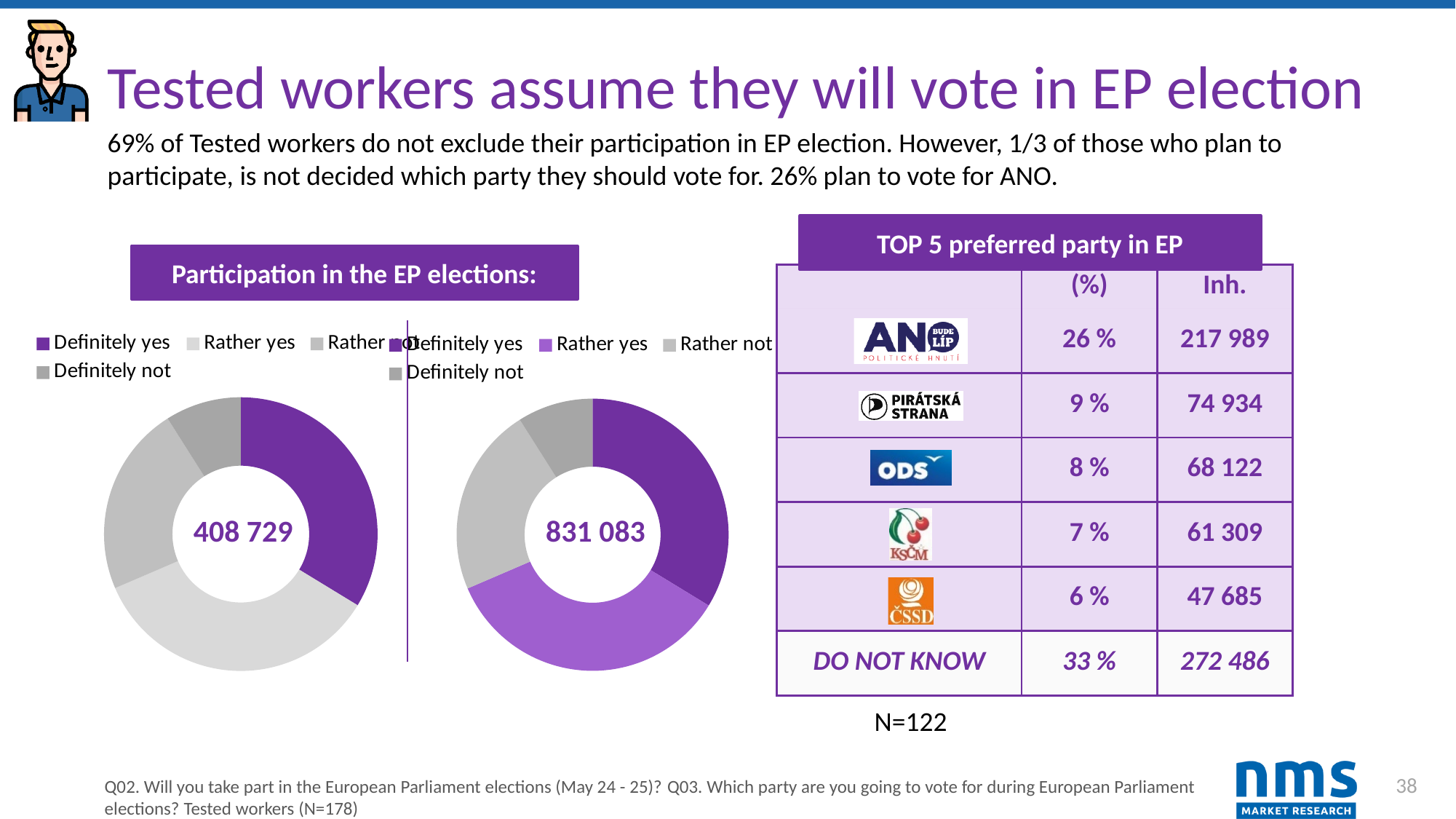
In the left donut chart, which slice is larger: 'Definitely yes' or 'Definitely not'? Definitely yes In the right donut chart, what colour represents 'Definitely yes'? Purple How many categories does the legend of the left donut chart list? 4 What kind of chart is the left chart under 'Participation in the EP elections:'? Donut (pie) chart What is the title shown above the two donut charts? Participation in the EP elections: What value is printed in the centre of the left donut chart? 408 729 In the right donut chart, which slice is larger: 'Rather yes' or 'Rather not'? Rather yes In the right donut chart, which category has the smallest slice? Definitely not What kind of chart is the right chart under 'Participation in the EP elections:'? Donut (pie) chart What value is printed in the centre of the right donut chart? 831 083 In the left donut chart, which category has the smallest slice? Definitely not How many slices does the right donut chart have? 4